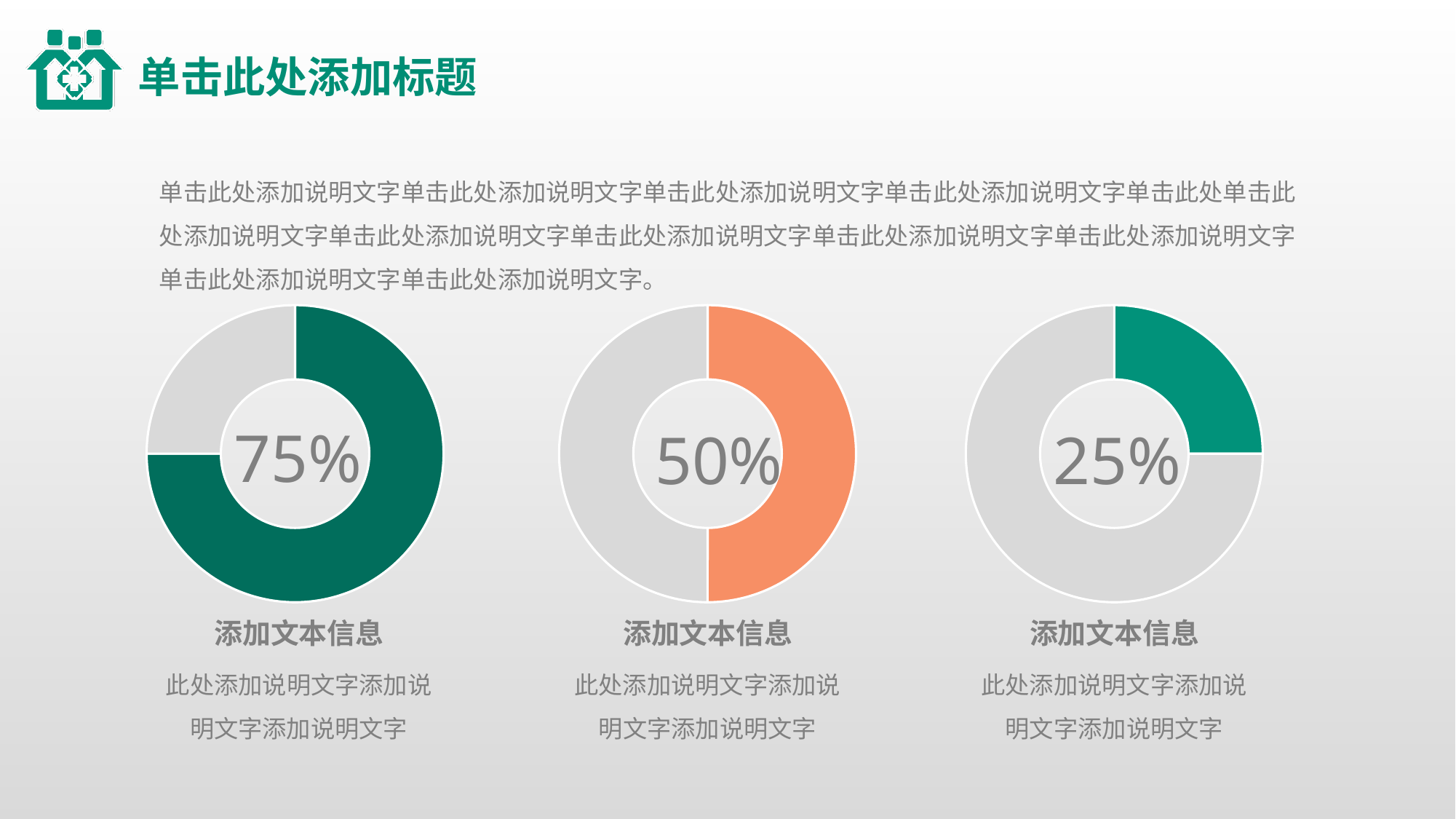
Do the percentages rise or fall when reading the donut charts from left to right? Fall What percentage is shown in the centre of the left donut chart? 75% What colour is the filled segment of the middle donut chart? Orange What kind of chart is used to display the percentages on the slide? Donut chart Which is larger, the percentage in the middle donut chart or the percentage in the right donut chart? The middle donut chart (50%) Which of the three donut charts shows the highest percentage? The left one (75%) What is the difference between the percentage in the left donut chart and the percentage in the right donut chart? 50% What percentage is shown in the centre of the right donut chart? 25% How many donut charts are shown on the slide? 3 What is the difference between the percentage in the left donut chart and the percentage in the middle donut chart? 25% Which of the three donut charts shows the lowest percentage? The right one (25%) What percentage is shown in the centre of the middle donut chart? 50%